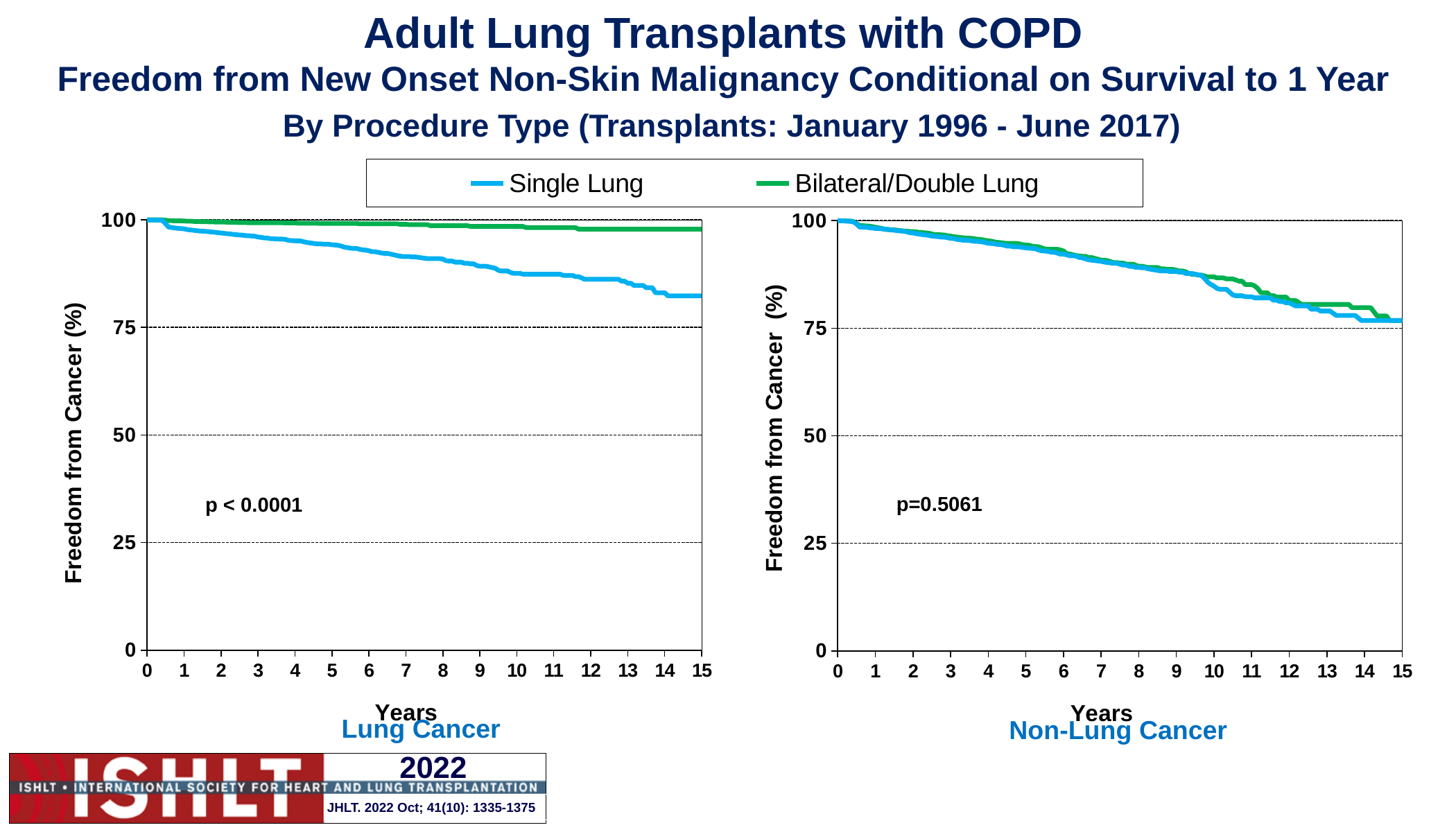
In the Lung Cancer chart, is the Single Lung value at 15 years greater or less than 75? greater In the Lung Cancer chart, is the Bilateral/Double Lung value at 15 years greater or less than 75? greater What p-value is shown on the Lung Cancer chart? p < 0.0001 In the Lung Cancer chart, does the Single Lung curve rise or fall as years increase? fall How many series does the legend list? 2 In the Non-Lung Cancer chart, is the Bilateral/Double Lung value at 15 years greater or less than 50? greater In the Lung Cancer chart, which series is higher at 10 years, Single Lung or Bilateral/Double Lung? Bilateral/Double Lung What kind of chart is the Lung Cancer chart on the left? line chart What p-value is shown on the Non-Lung Cancer chart? p=0.5061 In the Non-Lung Cancer chart, which series is higher at 11 years, Single Lung or Bilateral/Double Lung? Bilateral/Double Lung In the Non-Lung Cancer chart, does the Bilateral/Double Lung curve rise or fall as years increase? fall